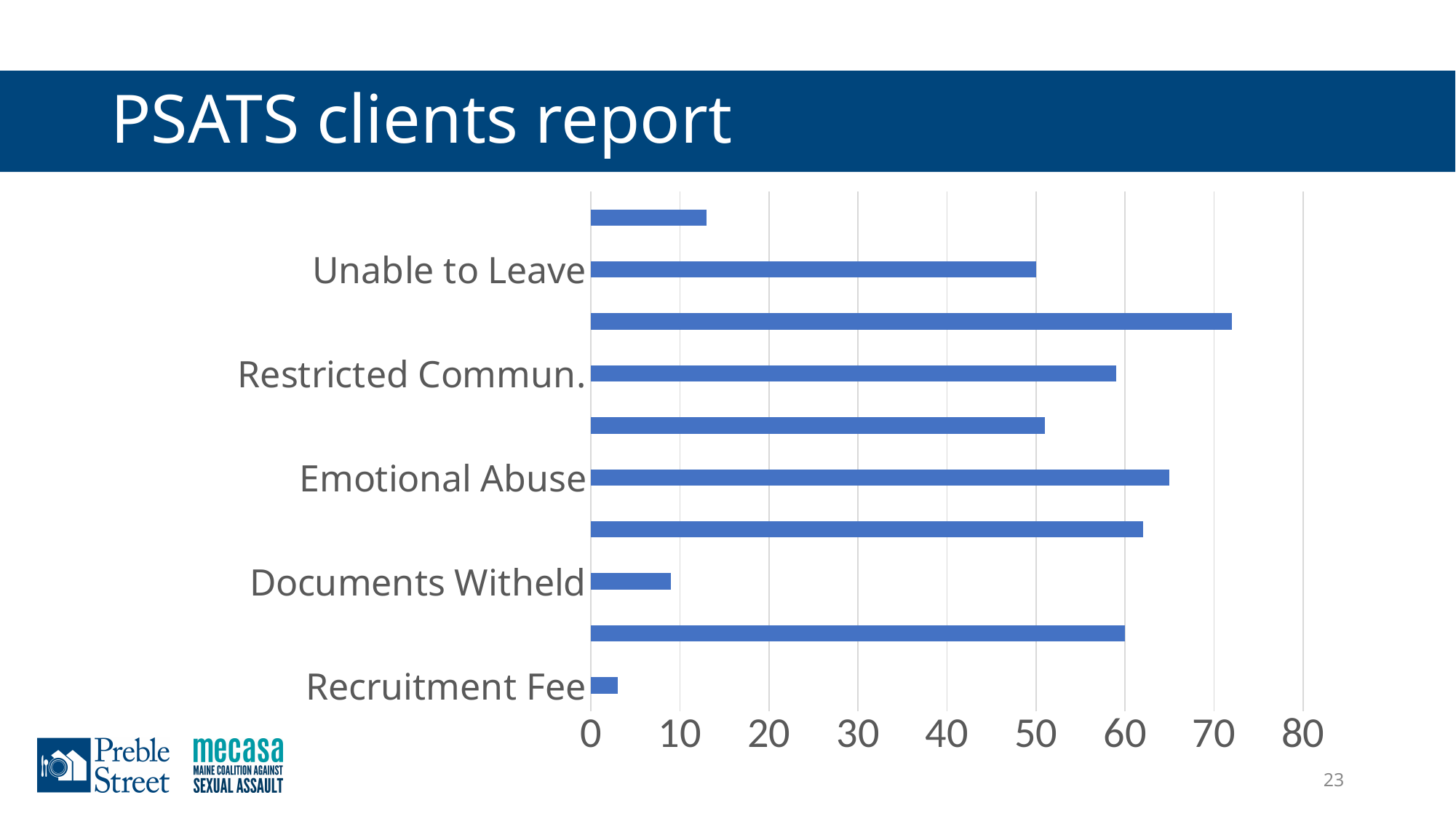
Which is larger, the value for Restricted Commun. or the value for Unable to Leave? Restricted Commun. Is the value for Documents Witheld greater or less than 10? less What is the highest value shown on the horizontal axis? 80 What is the title of the slide containing the chart? PSATS clients report Which category has the lowest value in the chart? Recruitment Fee Is the value for Emotional Abuse greater or less than 60? greater Is the value for Recruitment Fee greater or less than 10? less Among the labeled categories, which has the highest value? Emotional Abuse How many bars are plotted in the chart? 10 What kind of chart is shown on the slide? bar chart